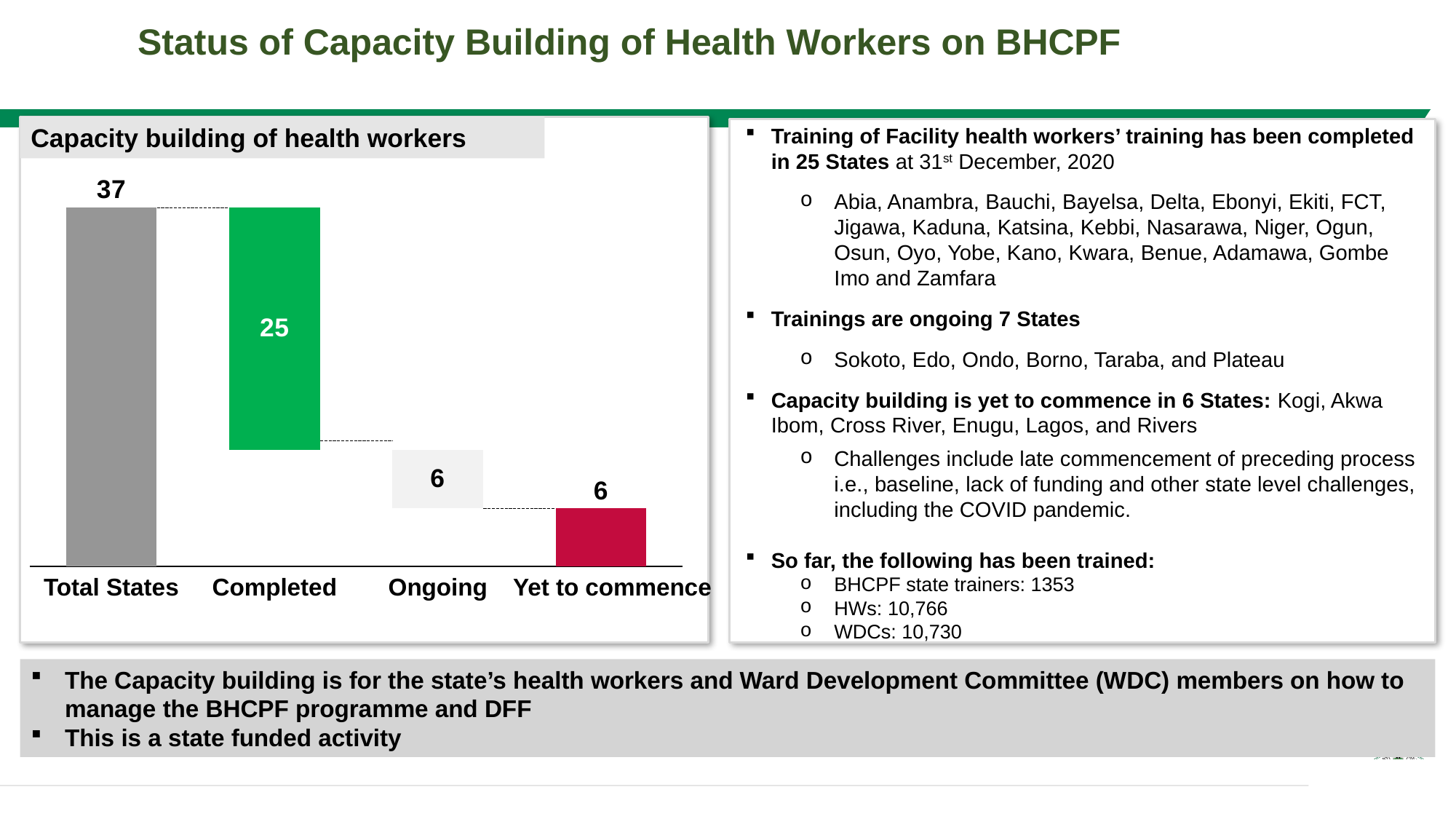
Which is larger in the chart, the value for Completed or the value for Ongoing? Completed What is the value for Completed in the Capacity building of health workers chart? 25 What kind of chart is shown on the slide? Bar chart What is the value for Total States in the Capacity building of health workers chart? 37 What is the value for Ongoing in the Capacity building of health workers chart? 6 What is the value for Yet to commence in the Capacity building of health workers chart? 6 What is the difference between the Completed value and the Ongoing value in the chart? 19 What is the difference between the Total States value and the Completed value in the chart? 12 Which category has the highest value in the Capacity building of health workers chart? Total States How many categories are shown on the x axis of the Capacity building of health workers chart? 4 What colour is the Completed bar in the chart? Green What is the title of the chart on the slide? Capacity building of health workers